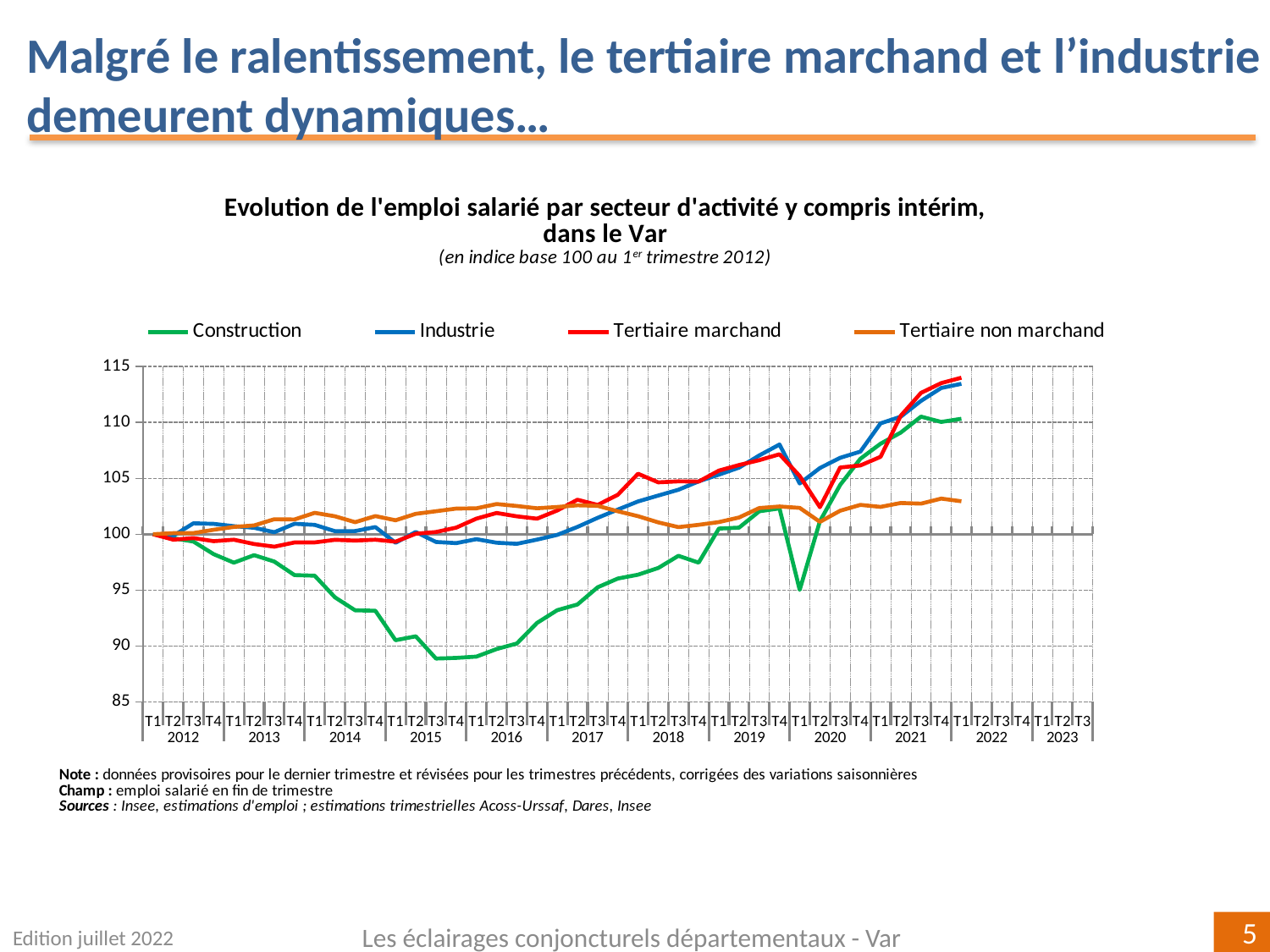
At T1 2022, which is higher: Tertiaire marchand or Tertiaire non marchand? Tertiaire marchand Does the Construction series rise or fall between T1 2012 and T3 2015? fall What is the title of the chart? Evolution de l'emploi salarié par secteur d'activité y compris intérim, dans le Var Is the value for Tertiaire marchand at T1 2022 greater or less than 110? greater Is the value for Construction at T1 2020 greater or less than 100? less Is the value for Construction at T3 2015 greater or less than 95? less What kind of chart is shown on the slide? line chart How many series does the legend list? 4 What is the value of every series at T1 2012? 100 Which series is drawn in green? Construction Which series has the lowest value at T3 2015? Construction